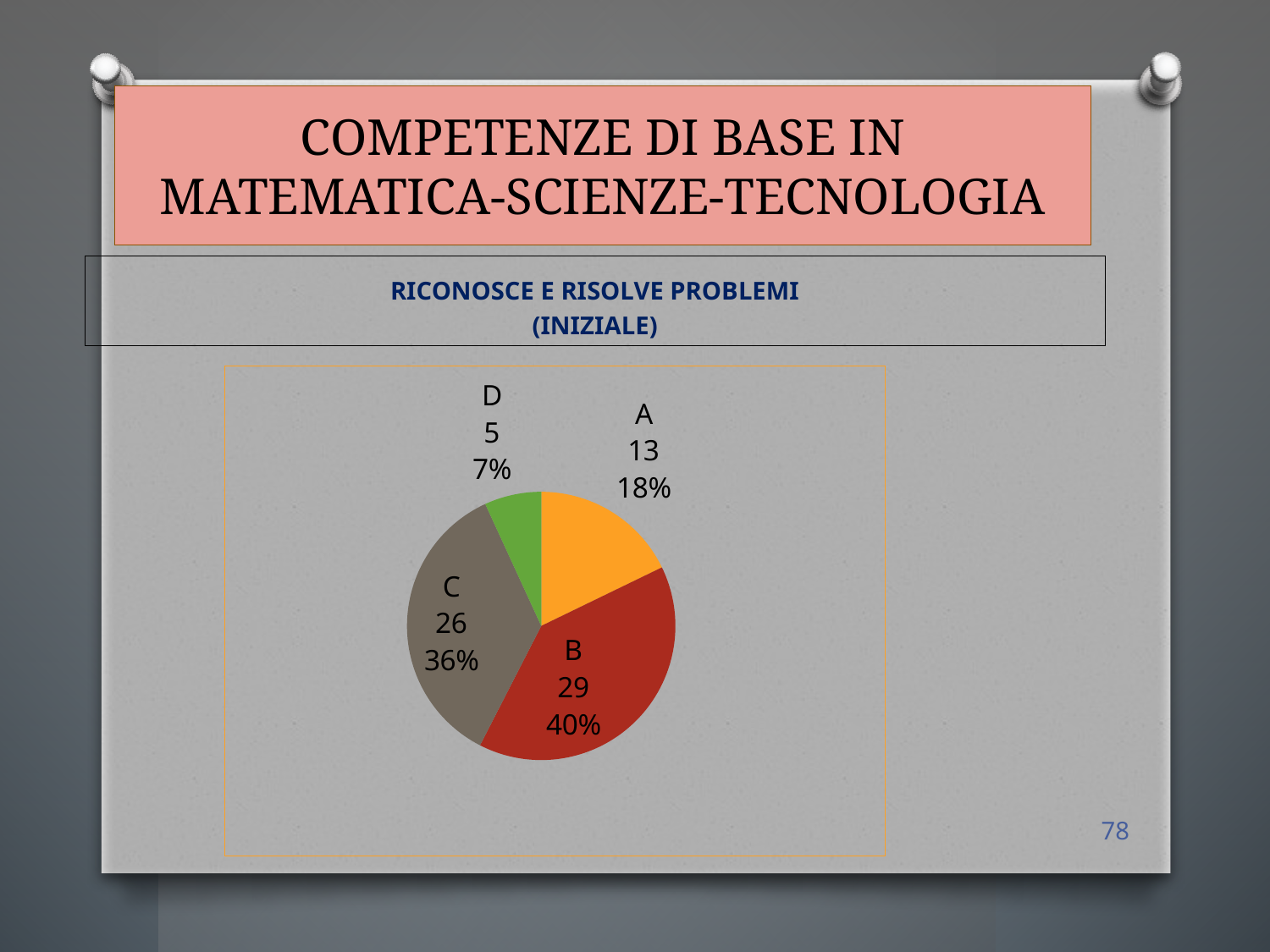
How many slices does the pie chart have? 4 What percentage share does category A have? 18% What is the value for category D? 5 What kind of chart is shown on the slide? pie chart Which is larger, the value for A or the value for D? A What is the value for category B? 29 Which category has the smallest slice? D What is the difference between the values for B and C? 3 What colour is the slice for category C? grey What is the total of all four slice values? 73 Which category has the largest slice? B What percentage share does category C have? 36%